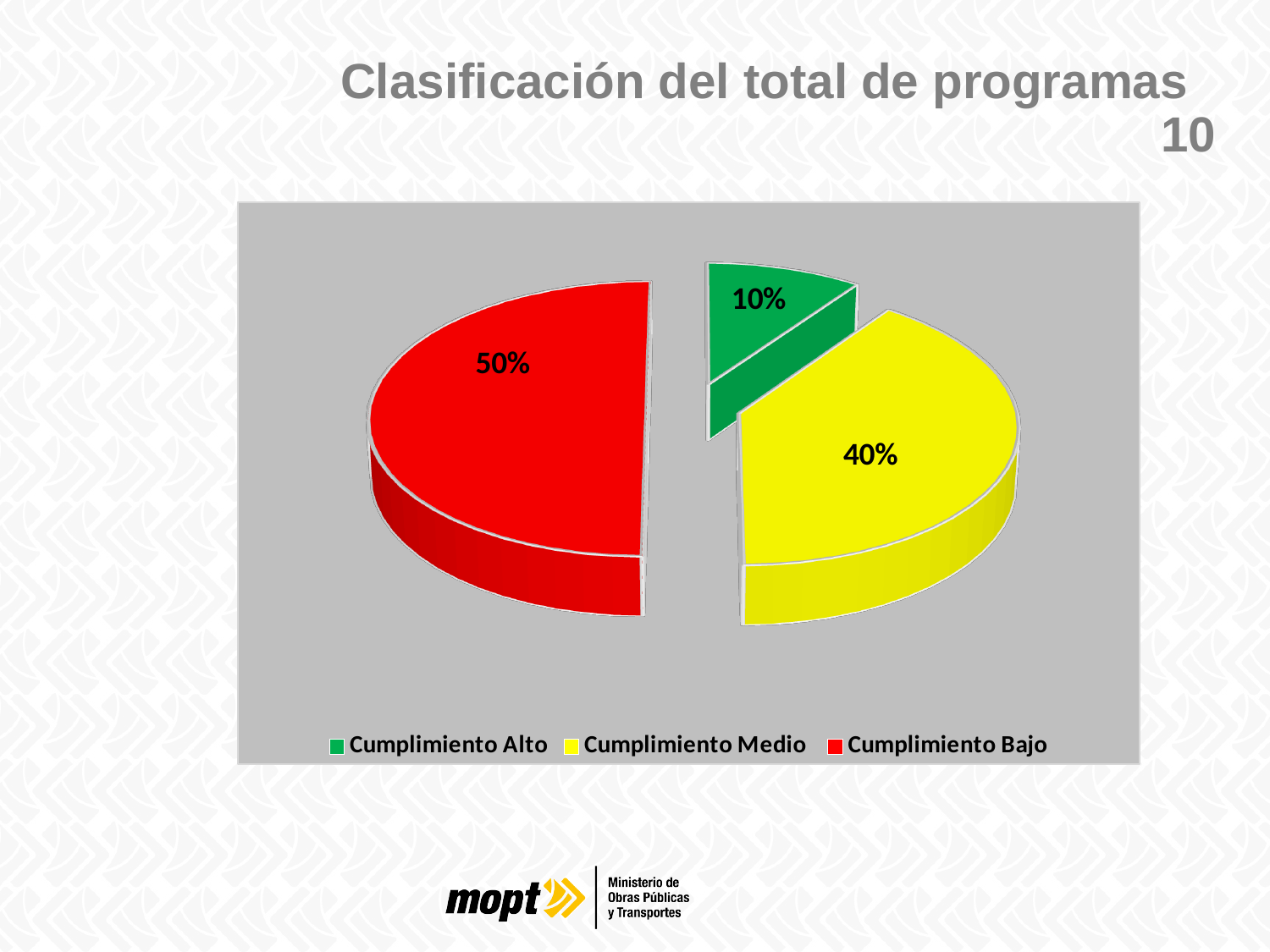
What percentage is shown for Cumplimiento Medio? 40% How many categories does the pie chart show? 3 Which category has the largest share of the pie? Cumplimiento Bajo What is the difference in percentage points between Cumplimiento Bajo and Cumplimiento Medio? 10 What colour represents Cumplimiento Bajo in the chart? Red Which category has the smallest share of the pie? Cumplimiento Alto Which is larger, the share for Cumplimiento Medio or the share for Cumplimiento Alto? Cumplimiento Medio What is the combined share of Cumplimiento Alto and Cumplimiento Medio? 50% What is the title of the slide containing the chart? Clasificación del total de programas What percentage is shown for Cumplimiento Alto? 10% What type of chart is shown on the slide? Pie chart What percentage is shown for Cumplimiento Bajo? 50%